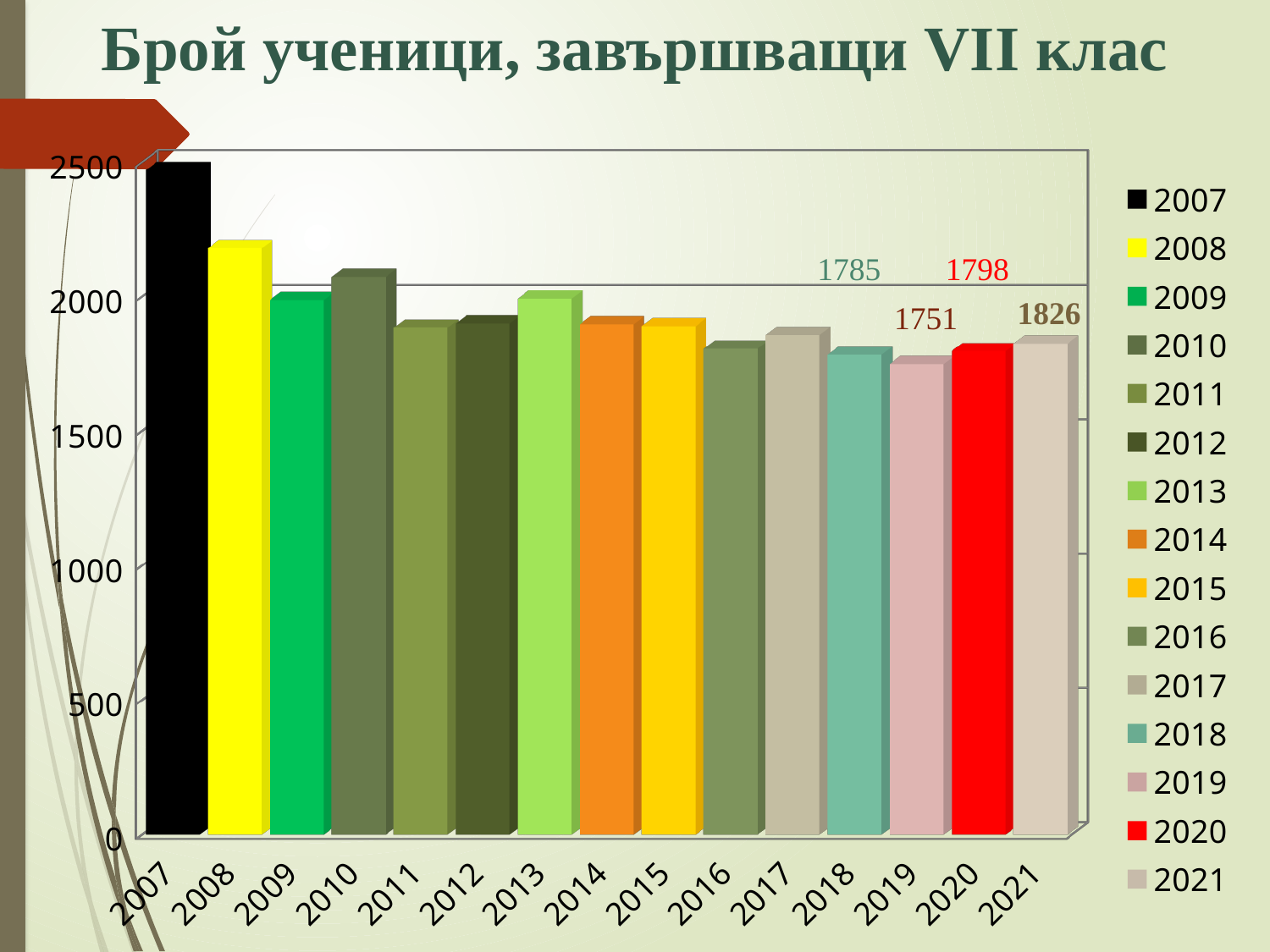
What is the difference between the values for 2021 and 2020? 28 What is the title of the chart? Брой ученици, завършващи VII клас Is the value for 2011 greater or less than 2000? less Which is larger, the value for 2007 or the value for 2008? 2007 What is the value for 2020? 1798 Which year has the lowest value? 2019 What is the value for 2021? 1826 What is the value for 2018? 1785 What kind of chart is shown on the slide? bar chart How many years are shown on the x axis? 15 Which year has the highest value? 2007 What is the value for 2019? 1751